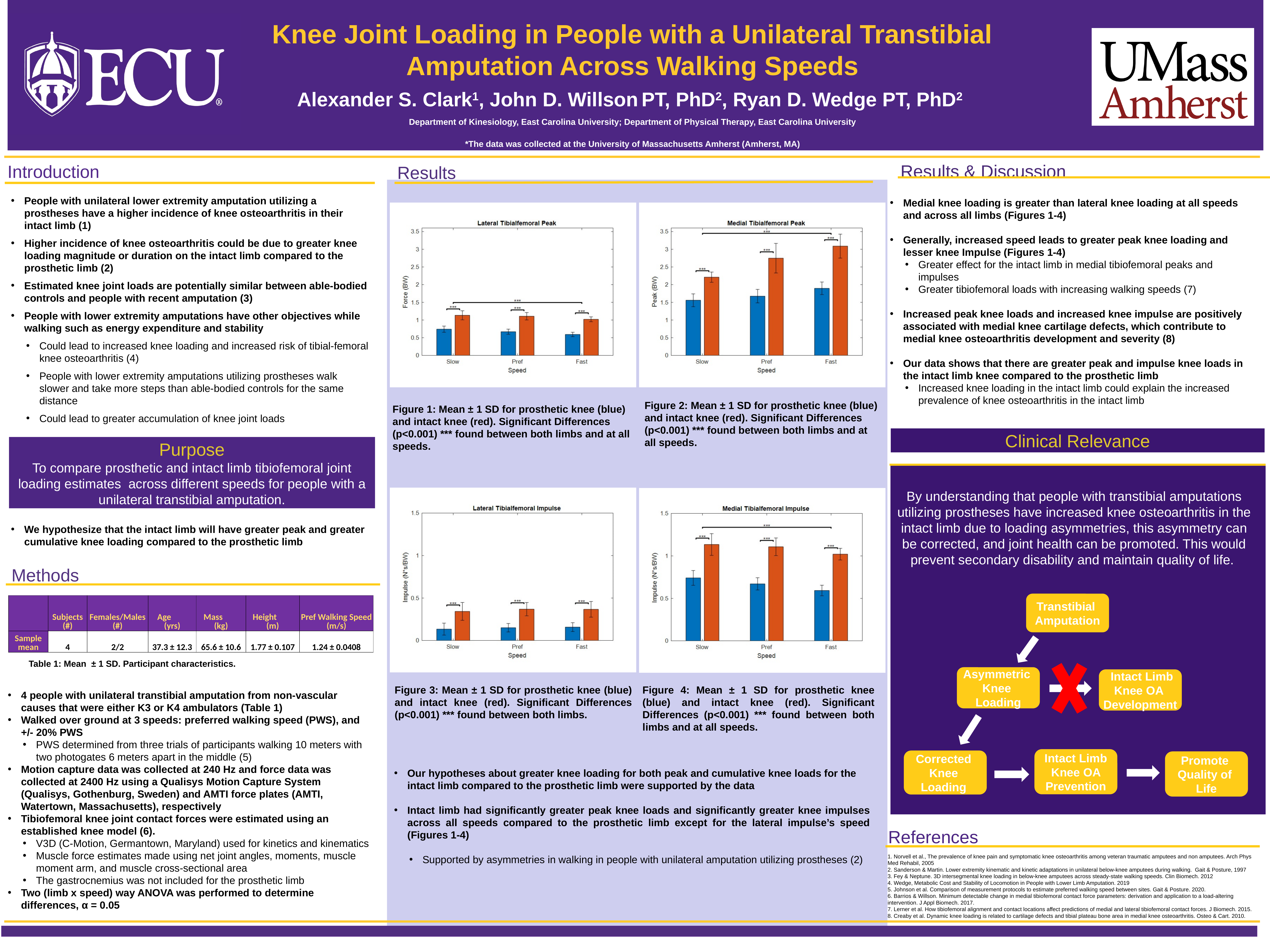
What kind of chart is the Lateral Tibialfemoral Peak chart? bar chart In the Medial Tibialfemoral Peak chart, do the red (intact knee) bars rise or fall from Slow to Fast? rise In the Medial Tibialfemoral Peak chart, at which speed is the red (intact knee) bar highest? Fast In the Lateral Tibialfemoral Peak chart, at which speed is the blue (prosthetic knee) bar lowest? Fast In the Medial Tibialfemoral Peak chart at Fast, which bar is larger, the blue (prosthetic) or the red (intact)? red (intact) What is the y-axis label of the Medial Tibialfemoral Impulse chart? Impulse (N*s/BW) In the Medial Tibialfemoral Impulse chart, is the red (intact knee) bar at Slow greater or less than 1? greater How many speed categories are shown on the x axis of the Medial Tibialfemoral Peak chart? 3 In the Lateral Tibialfemoral Impulse chart, is the red (intact knee) bar at Pref greater or less than 0.5? less